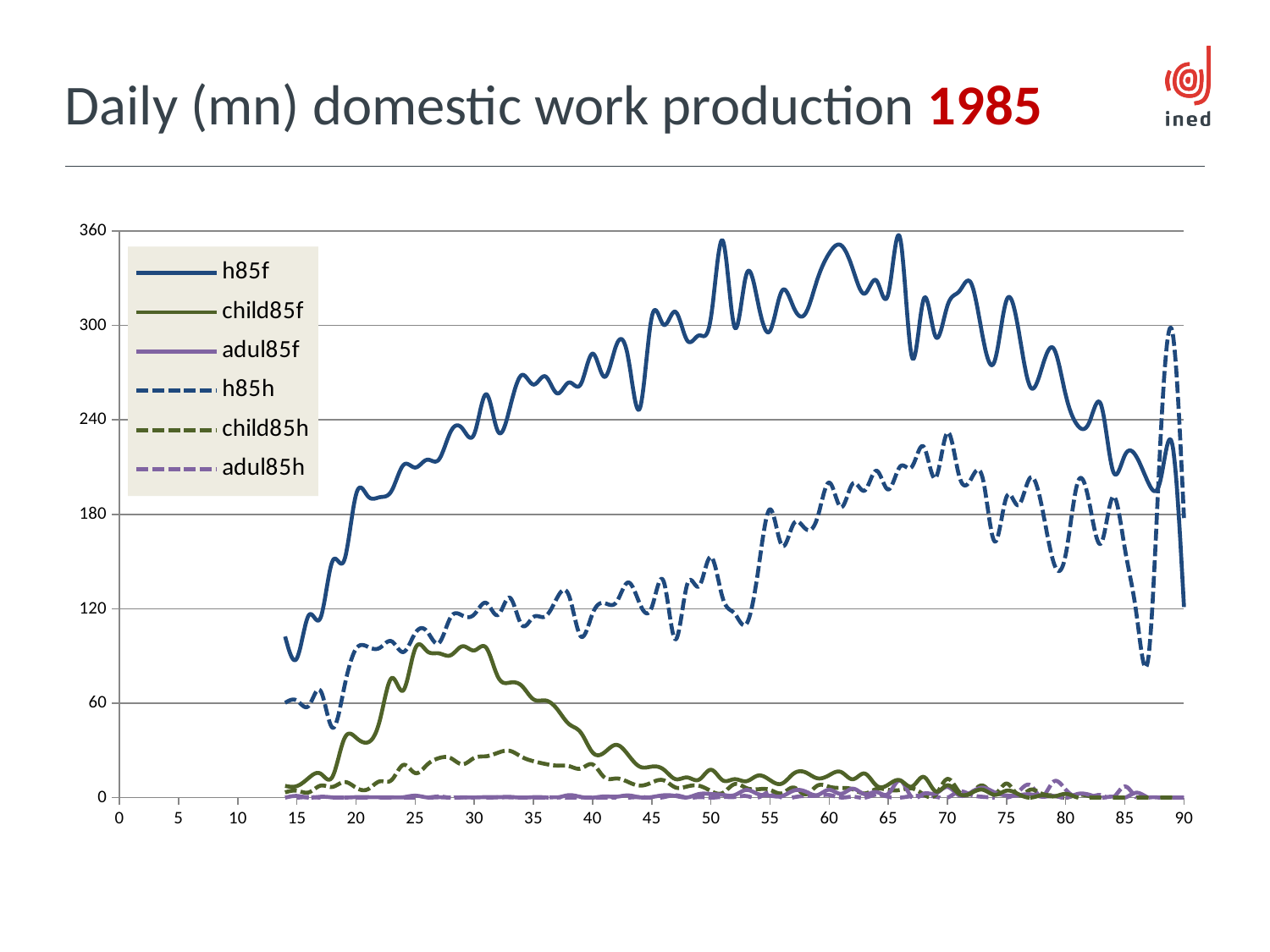
Is the value of child85f at x = 45 greater or less than 60? less Does the h85f series generally rise or fall between x = 15 and x = 60? rise At x = 30, which series has the larger value, child85f or child85h? child85f Is the value of h85f at x = 60 greater or less than 300? greater Is the value of h85h at x = 30 greater or less than 180? less How many series does the legend list? 6 What kind of chart is shown on the slide? line chart What is the title of the slide containing the chart? Daily (mn) domestic work production 1985 Which series reaches the highest values on the chart? h85f At x = 50, which series has the larger value, h85f or h85h? h85f